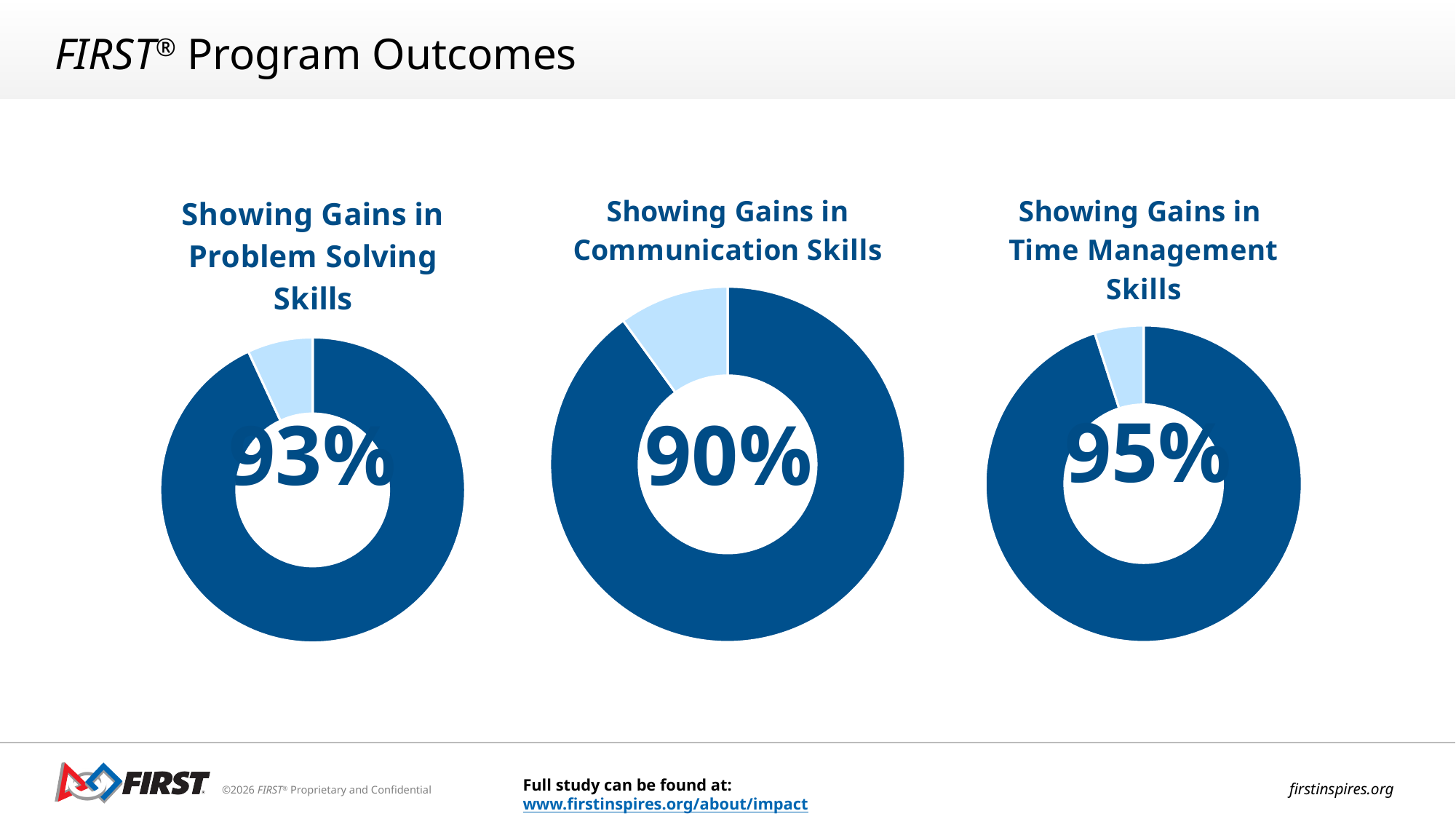
In the 'Showing Gains in Problem Solving Skills' chart, what percentage is shown in the centre? 93% How many charts are shown on the slide? 3 What is the title of the slide? FIRST® Program Outcomes What is the difference between the percentage in the 'Time Management Skills' chart and the percentage in the 'Communication Skills' chart? 5% Which is larger: the percentage in the 'Problem Solving Skills' chart or the percentage in the 'Time Management Skills' chart? Time Management Skills In the 'Showing Gains in Time Management Skills' chart, what percentage is shown in the centre? 95% What kind of chart is used for 'Showing Gains in Communication Skills'? Doughnut chart What is the difference between the percentage in the 'Problem Solving Skills' chart and the percentage in the 'Communication Skills' chart? 3% In the 'Showing Gains in Communication Skills' chart, what percentage is shown in the centre? 90% Across the three charts, which skill area shows the lowest percentage? Communication Skills Across the three charts, which skill area shows the highest percentage? Time Management Skills